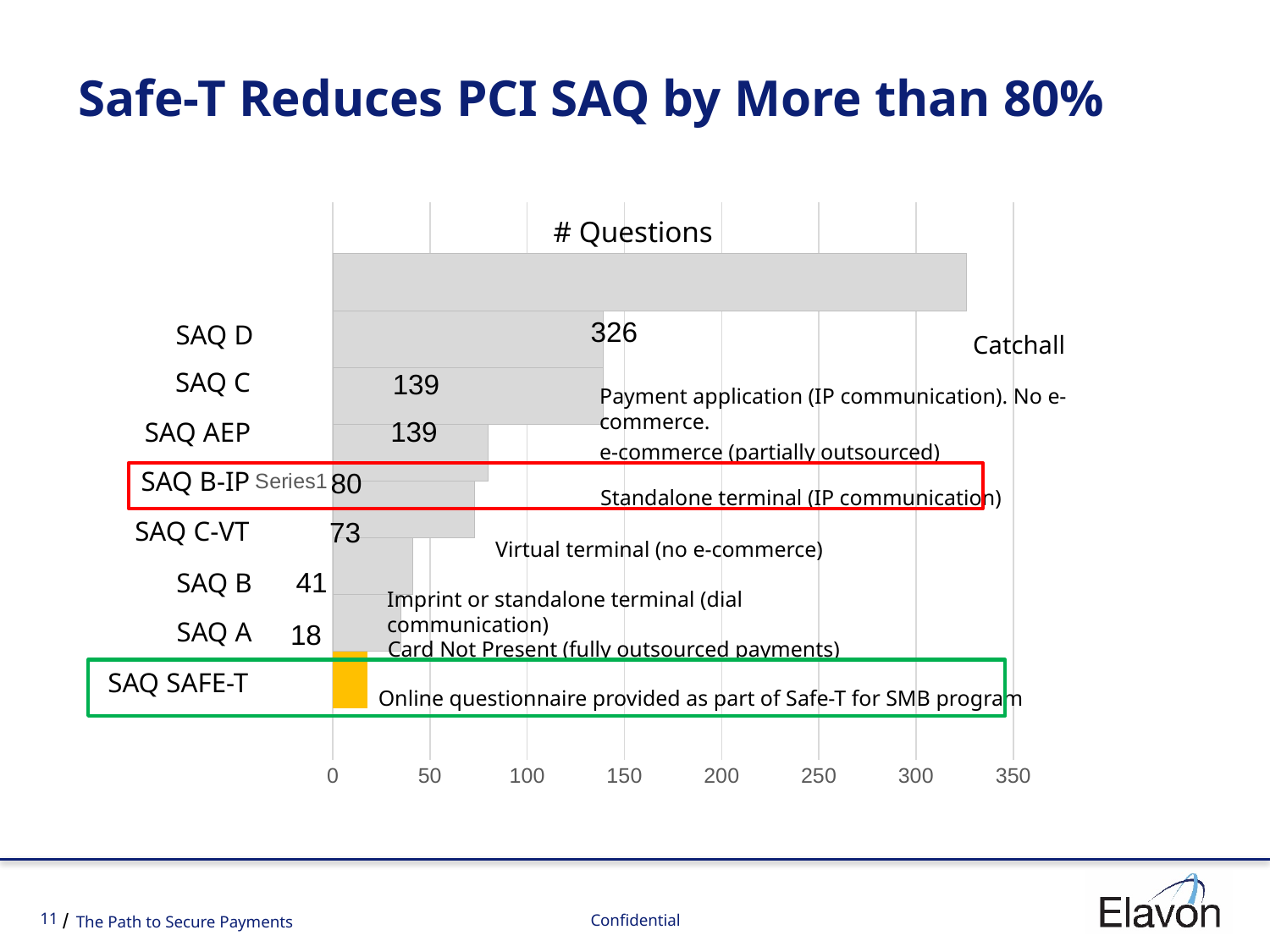
What is the difference between the values for SAQ D and SAQ C? 187 Which is larger, the value for SAQ B-IP or the value for SAQ C-VT? SAQ B-IP How many questions are shown for SAQ D? 326 What is the value for SAQ B-IP? 80 What is the value for SAQ C-VT? 73 What kind of chart is shown on the slide? bar chart What is the title of the chart? # Questions Which SAQ category has the highest number of questions? SAQ D Is the value for SAQ SAFE-T greater or less than 50? less What is the value for SAQ A? 18 What is the difference between the values for SAQ B and SAQ A? 23 How many SAQ categories are listed on the chart? 8